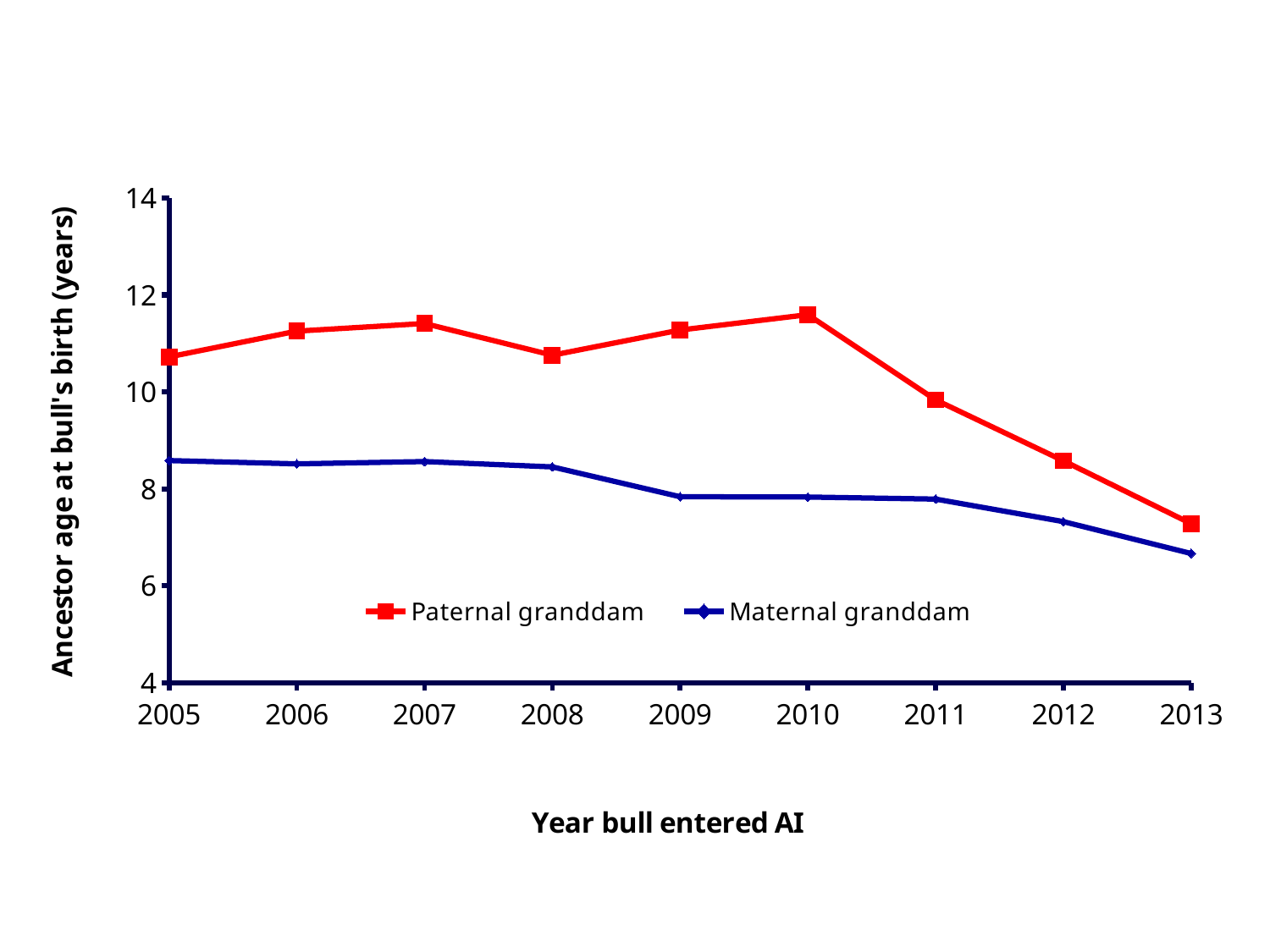
What kind of chart is shown on the slide? line chart In which year is the Maternal granddam value lowest? 2013 What is the label of the y axis? Ancestor age at bull's birth (years) How many years are shown on the x axis? 9 In which year is the Paternal granddam value lowest? 2013 Does the Paternal granddam series rise or fall from 2010 to 2013? fall How many series does the legend list? 2 Is the Maternal granddam value for 2013 greater or less than 8? less Is the Paternal granddam value for 2010 greater or less than 10? greater In which year is the Paternal granddam value highest? 2010 Which series has the larger value in 2011, Paternal granddam or Maternal granddam? Paternal granddam Which series is plotted in red? Paternal granddam